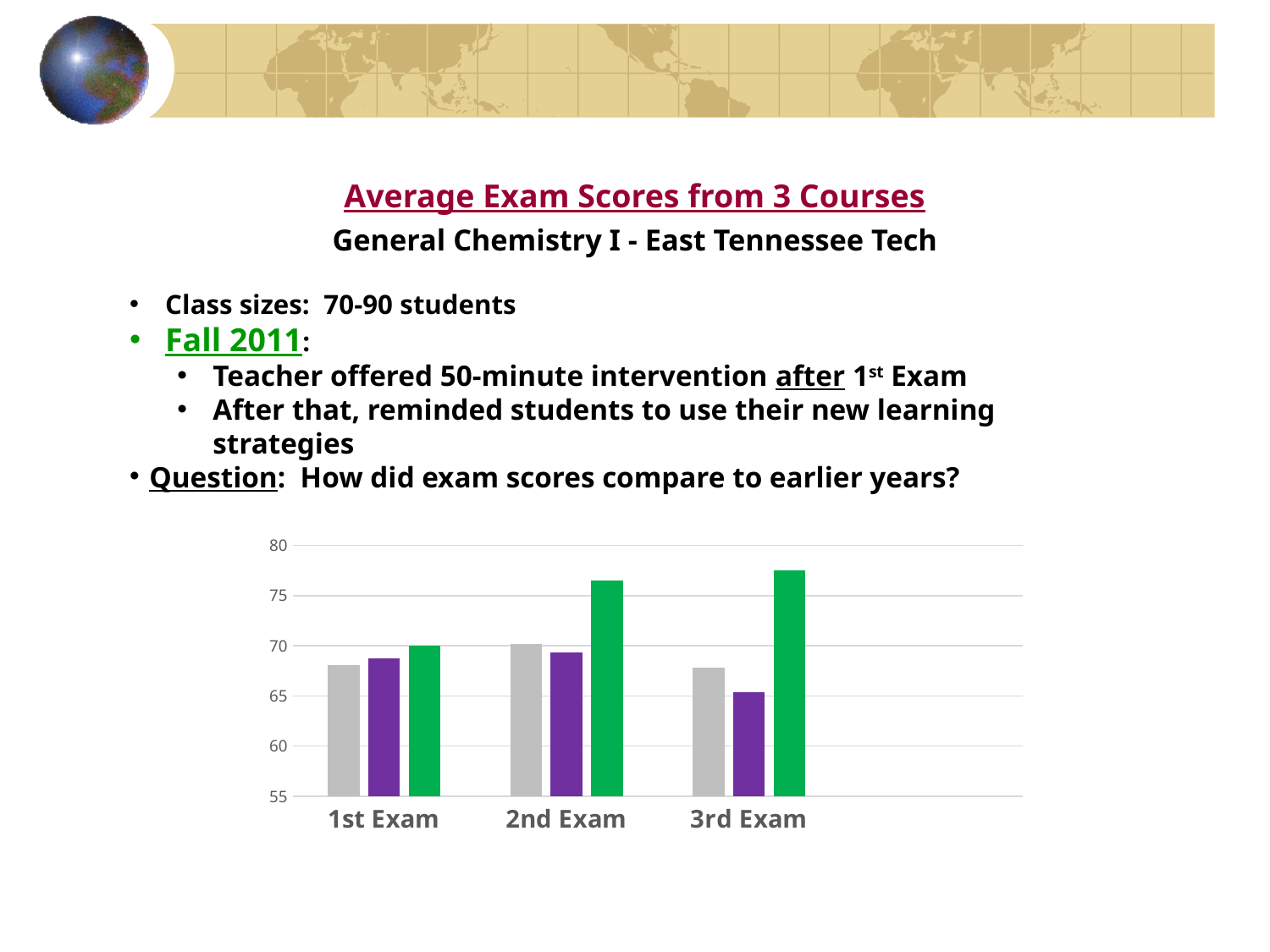
How many bars are plotted for each exam category in the chart? 3 What kind of chart is shown on the slide? bar chart What is the highest value shown on the chart's vertical axis? 80 Is the value of the green bar for 3rd Exam greater or less than 75? greater Is the value of the green bar for 2nd Exam greater or less than 75? greater For 3rd Exam, which bar is taller, the green bar or the purple bar? green bar Is the value of the gray bar for 3rd Exam greater or less than 70? less Do the green bars rise or fall from 1st Exam to 3rd Exam? rise For 2nd Exam, which bar is taller, the green bar or the gray bar? green bar For which exam is the purple bar lowest? 3rd Exam How many exam categories are shown on the x axis of the chart? 3